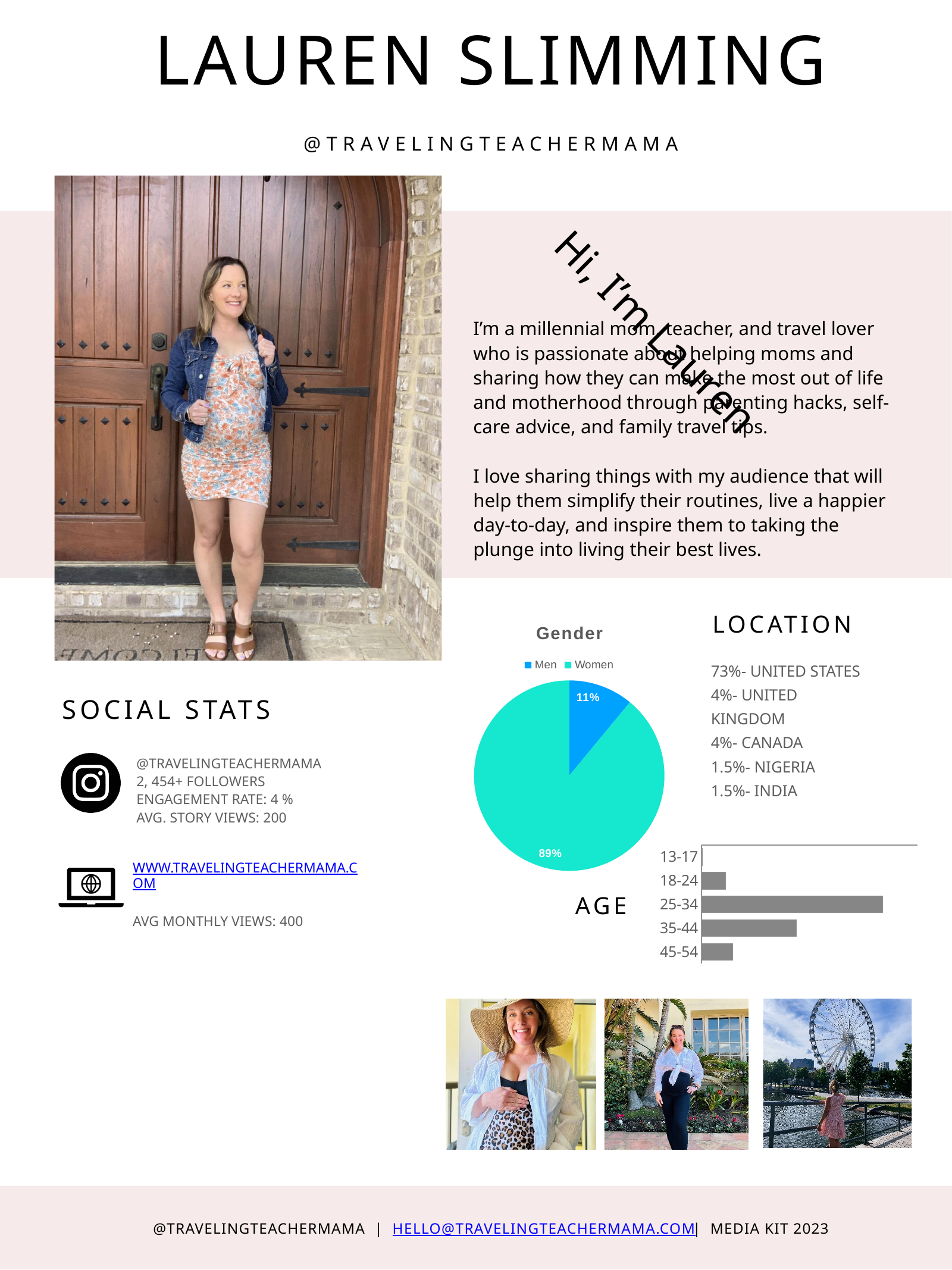
How many age categories are shown in the Age chart? 5 What type of chart is the Age chart? Bar chart In the Gender pie chart, which group has the smallest share? Men How many entries does the legend of the Gender chart list? 2 In the Age chart, which age group has the longest bar? 25-34 In the Gender pie chart, which group has the largest share? Women What type of chart is the Gender chart? Pie chart In the Gender pie chart, what is the difference in percentage points between Women and Men? 78% In the Age chart, which has the larger value: 35-44 or 18-24? 35-44 In the Age chart, which age group has the shortest bar? 13-17 In the Gender pie chart, what percentage of the audience is Men? 11% In the Gender pie chart, what percentage of the audience is Women? 89%